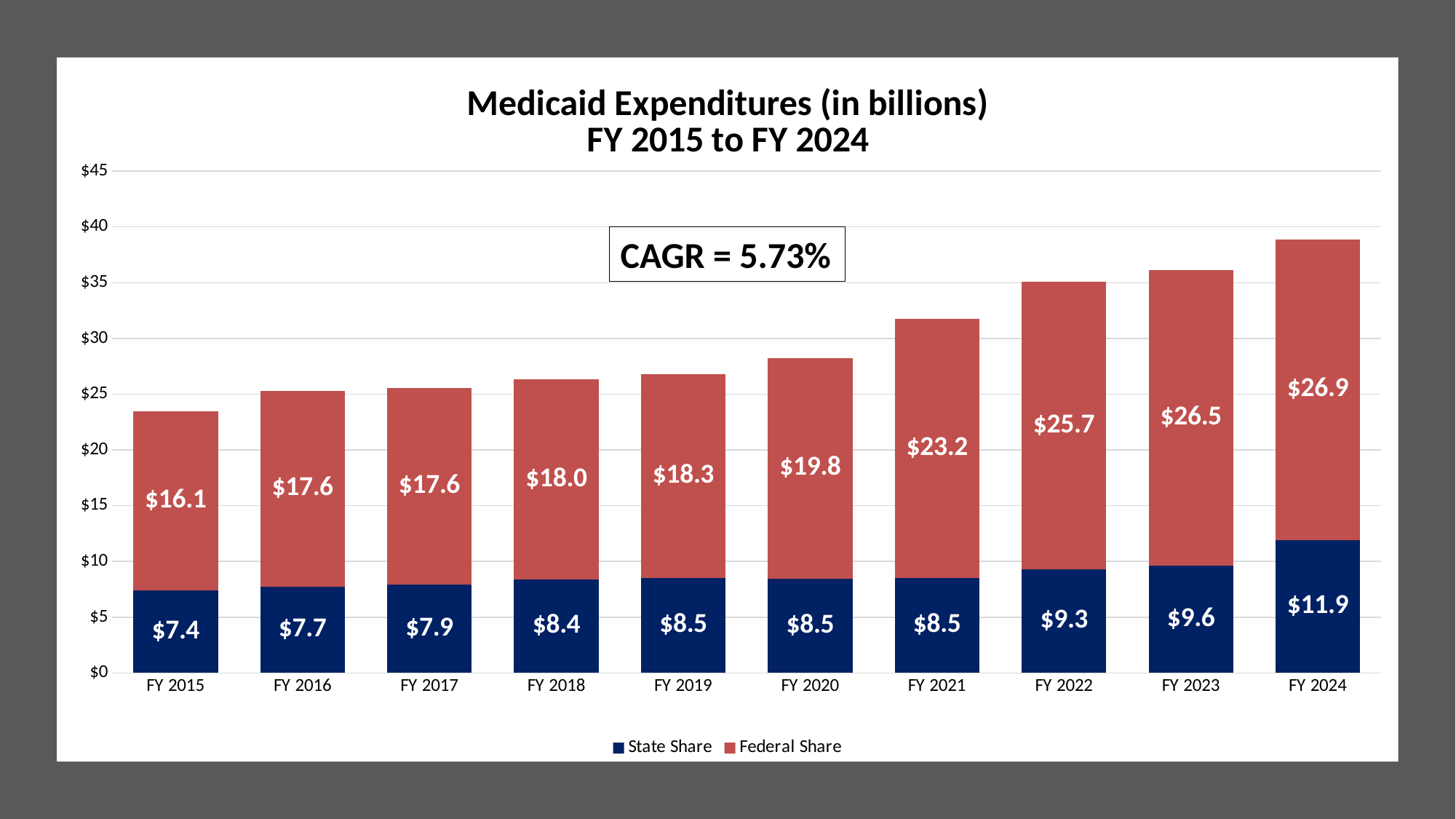
What is the Federal Share for FY 2020? $19.8 Which is larger, the Federal Share in FY 2021 or in FY 2020? FY 2021 What is the difference between the Federal Share in FY 2024 and FY 2015? $10.8 What CAGR value is shown in the box on the chart? 5.73% How many series does the legend list? 2 What is the State Share for FY 2018? $8.4 Which fiscal year has the lowest Federal Share? FY 2015 Is the total bar for FY 2024 greater or less than $35? greater How many fiscal years are shown on the x axis? 10 Which fiscal year has the highest State Share? FY 2024 What is the difference between the State Share in FY 2024 and FY 2023? $2.3 What is the total Medicaid expenditure for FY 2015 (State Share plus Federal Share)? $23.5